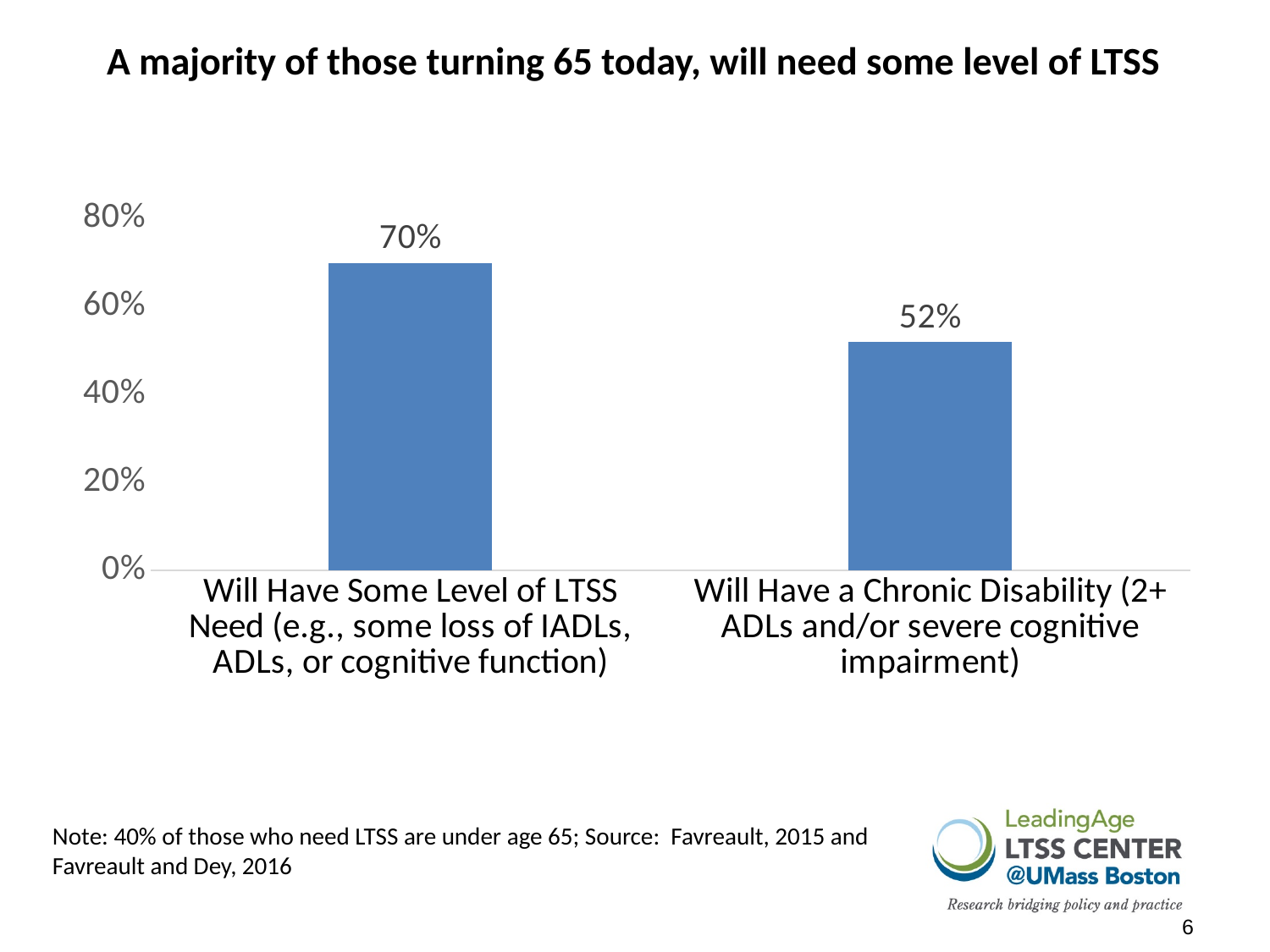
Which category has the lower value? Will Have a Chronic Disability What type of chart is shown on the slide? Bar chart What percentage of those turning 65 today will have some level of LTSS need? 70% Is the value for 'Will Have Some Level of LTSS Need' larger or smaller than the value for 'Will Have a Chronic Disability'? larger What is the title of the slide? A majority of those turning 65 today, will need some level of LTSS What is the highest value shown on the vertical axis? 80% Is the value for 'Will Have a Chronic Disability' greater or less than 60%? less Is the value for 'Will Have Some Level of LTSS Need' greater or less than 60%? greater What is the difference in percentage points between the share who will have some level of LTSS need and the share who will have a chronic disability? 18 percentage points Which category has the higher value? Will Have Some Level of LTSS Need What percentage of those turning 65 today will have a chronic disability (2+ ADLs and/or severe cognitive impairment)? 52% How many categories are shown in the chart? 2